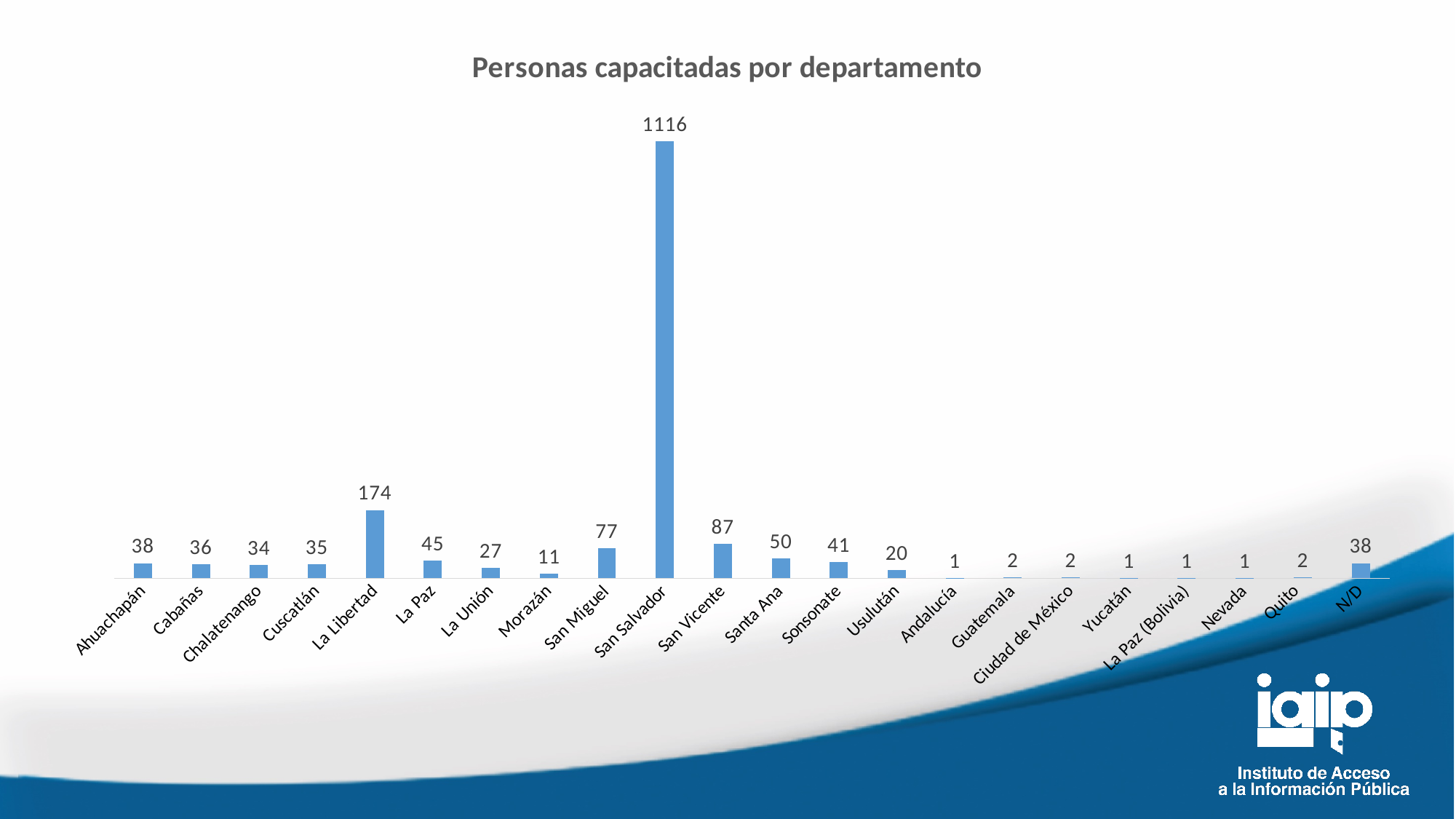
What is the value for San Salvador? 1116 What is the difference between the values for San Vicente and San Miguel? 10 Which is larger, the value for La Paz or the value for Sonsonate? La Paz What is the value for N/D? 38 What is the title of the chart? Personas capacitadas por departamento Which category has the highest value? San Salvador Which is larger, the value for La Unión or the value for Usulután? La Unión What is the value for Morazán? 11 How many categories are shown on the x axis? 22 What is the value for La Libertad? 174 What kind of chart is shown on the slide? Bar chart What is the difference between the values for La Libertad and Santa Ana? 124